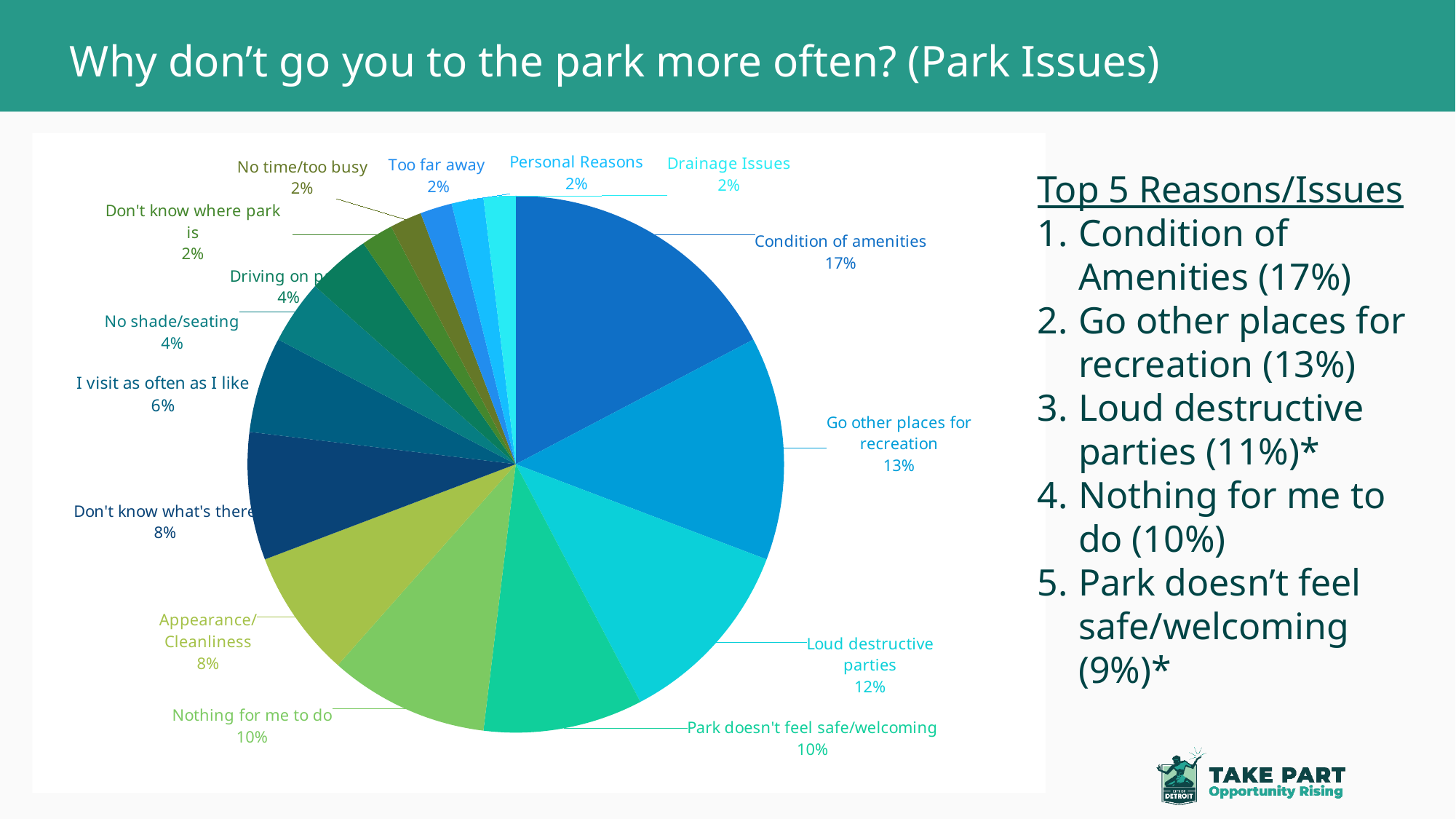
What share of the pie does Loud destructive parties have according to the chart's data label? 12% What percentage is shown for Park doesn't feel safe/welcoming? 10% What percentage is shown for I visit as often as I like? 6% What percentage is shown for Appearance/Cleanliness? 8% What is the difference in percentage points between Condition of amenities and Go other places for recreation? 4 Which category has the largest share of the pie? Condition of amenities What is the smallest percentage shown on any slice of the pie? 2% What percentage is shown for Condition of amenities? 17% Which is larger, the share for Don't know what's there or the share for No shade/seating? Don't know what's there What kind of chart is shown on the slide? pie chart What percentage is shown for Go other places for recreation? 13% How many slices does the pie chart have? 15